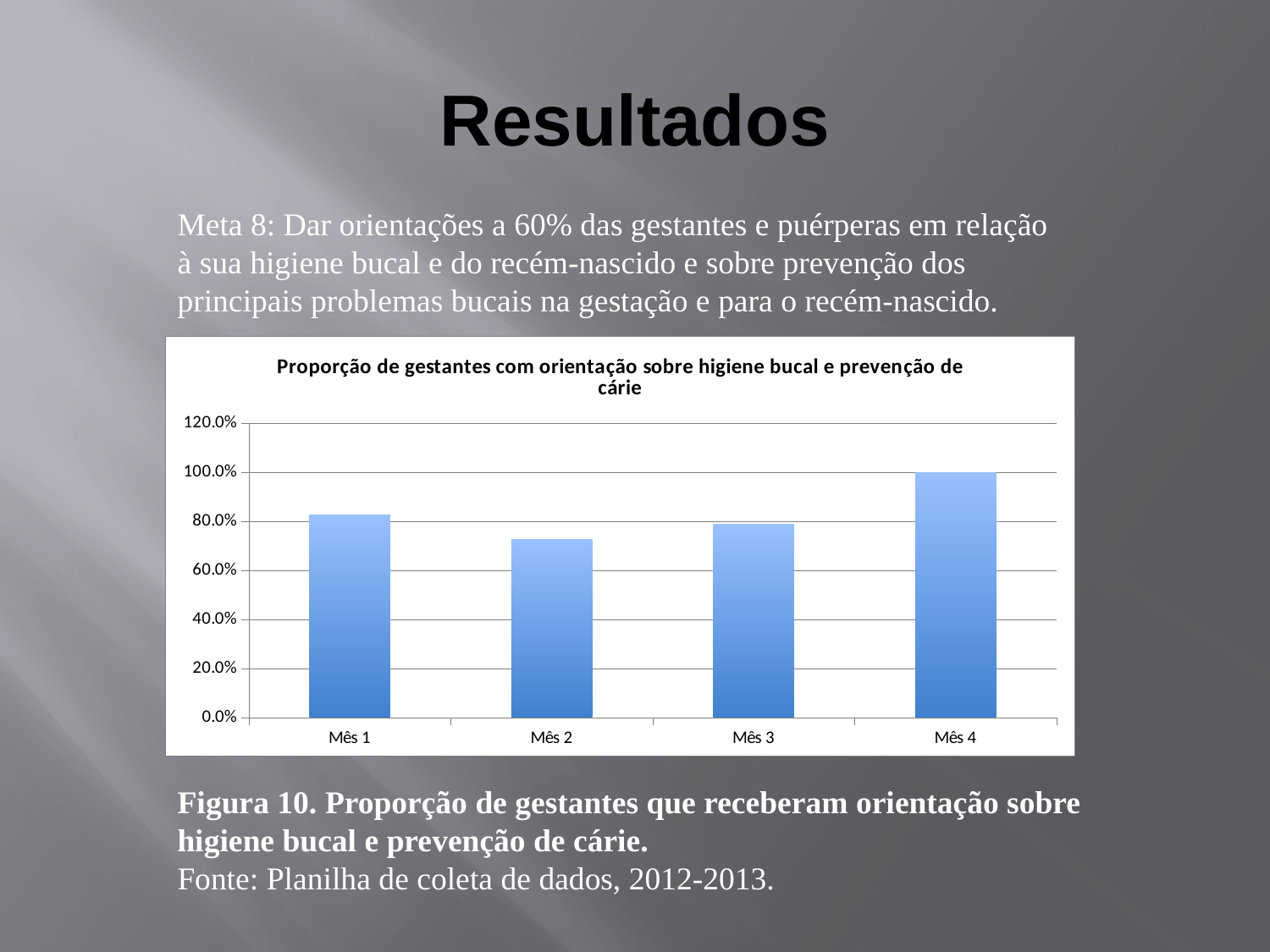
Which is larger, the value for Mês 1 or the value for Mês 2? Mês 1 What is the value for Mês 4 in the chart? 100.0% Which month has the lowest proportion in the chart? Mês 2 Is the value for Mês 4 greater or less than 80.0%? greater What is the title of the chart? Proporção de gestantes com orientação sobre higiene bucal e prevenção de cárie Is the value for Mês 1 greater or less than 60.0%? greater Does the value rise or fall from Mês 3 to Mês 4? rise What type of chart is shown on the slide? bar chart Is the value for Mês 2 greater or less than 80.0%? less How many months (categories) are shown on the x axis of the chart? 4 Which month has the highest proportion of gestantes with orientação sobre higiene bucal? Mês 4